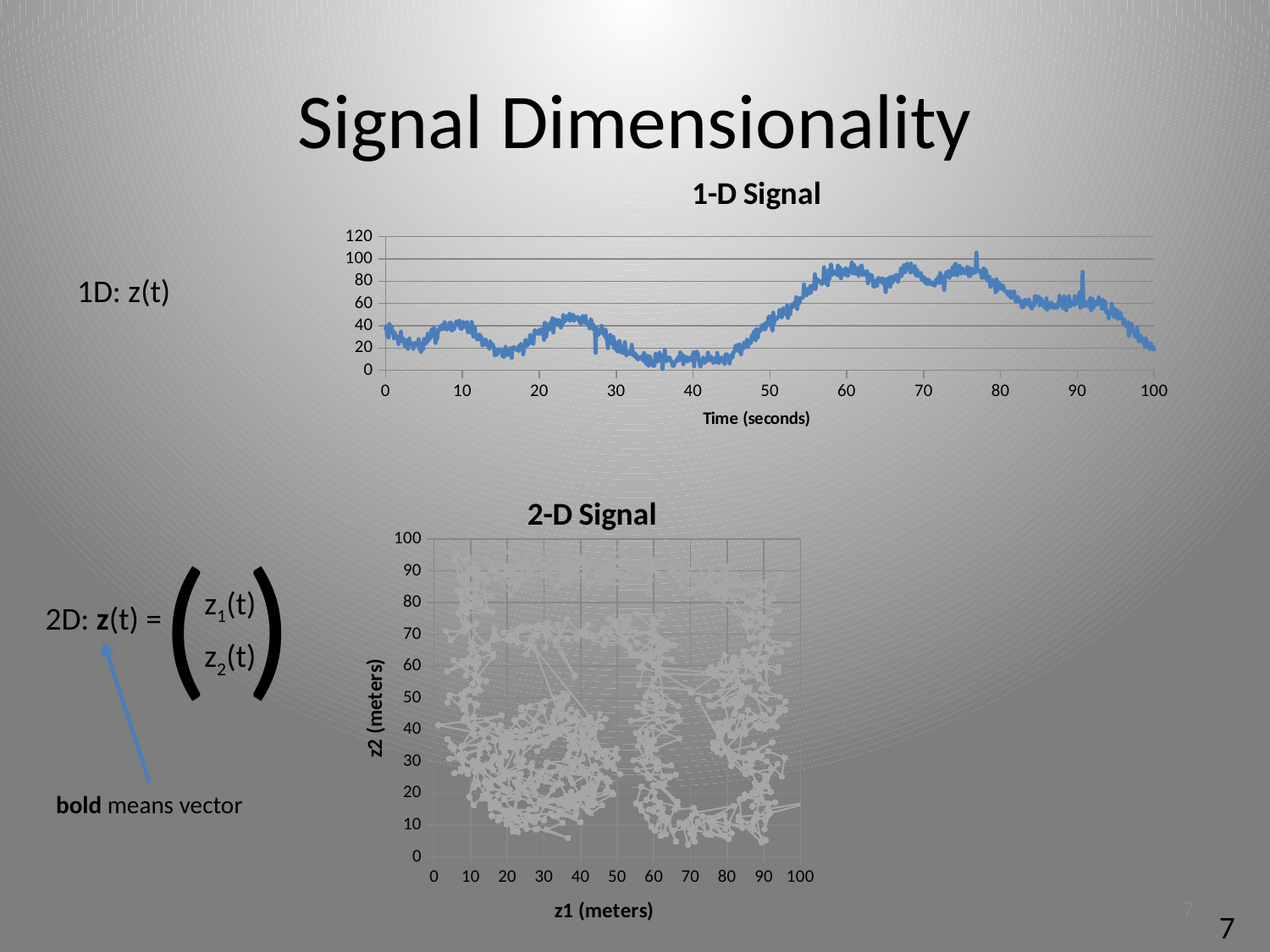
What is the title of the top chart on the slide? 1-D Signal In the 2-D Signal chart, what is the label of the x axis? z1 (meters) In the 1-D Signal chart, does the signal rise or fall between 80 and 100 seconds? fall In the 1-D Signal chart, is the value at 40 seconds greater or less than 20? less In the 1-D Signal chart, is the value at 100 seconds greater or less than 40? less In the 1-D Signal chart, what is the label of the x axis? Time (seconds) In the 1-D Signal chart, does the signal rise or fall between 45 and 55 seconds? rise What kind of chart is the 1-D Signal chart? line chart In the 1-D Signal chart, is the value at 60 seconds greater or less than 60? greater